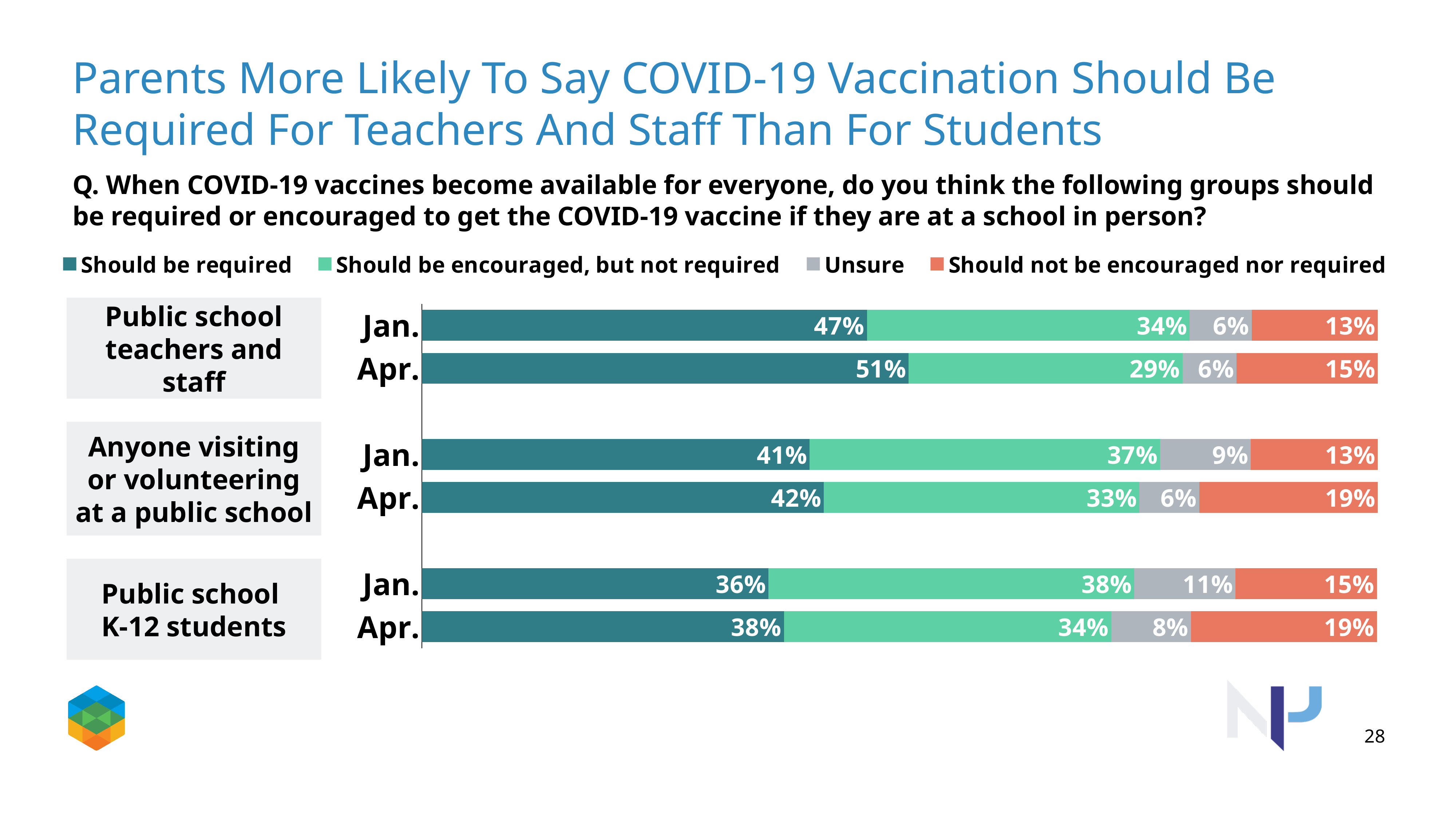
What type of chart is shown on the slide? Stacked bar chart What share of parents were unsure about anyone visiting or volunteering at a public school in January? 9% What percentage said public school K-12 students should be required to get the vaccine in January? 36% Which is larger: the 'Should be encouraged, but not required' share for K-12 students in January or in April? January What percentage said public school K-12 students should not be encouraged nor required to get the vaccine in April? 19% Which group had the lowest 'Should be required' percentage in January? Public school K-12 students Which group had the highest 'Should be required' percentage in April? Public school teachers and staff Which colour represents 'Unsure' in the chart? Gray By how many percentage points did 'Should be required' for public school teachers and staff change from January to April? 4 percentage points How many bars are shown in the chart? 6 What percentage of parents said public school teachers and staff should be required to get the COVID-19 vaccine in April? 51% How many response categories does the legend list? 4